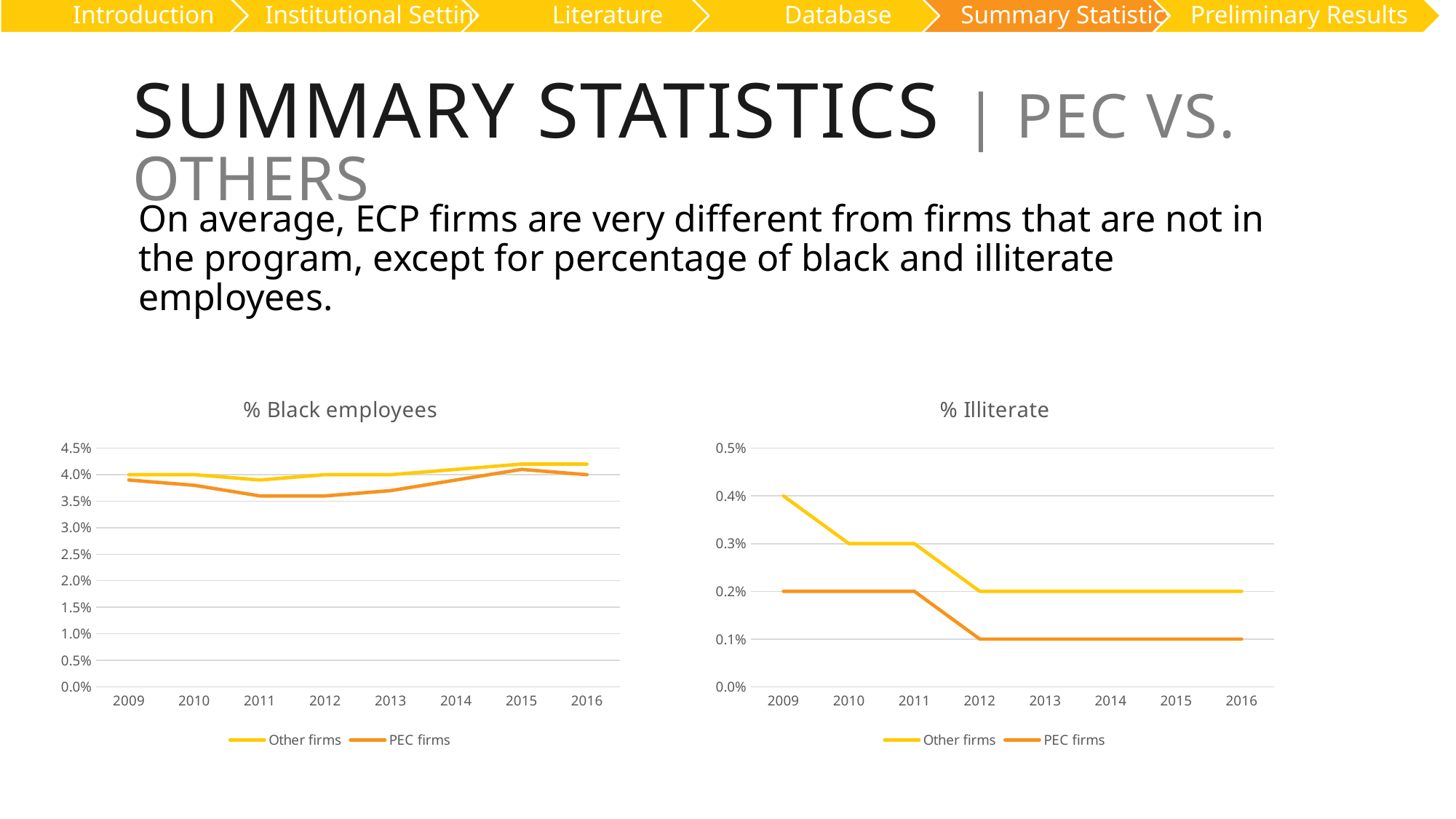
In the "% Black employees" chart, is the value for PEC firms in 2011 greater or less than 4.0%? less In the "% Black employees" chart, which series is higher in 2012, Other firms or PEC firms? Other firms How many series does the legend of the "% Illiterate" chart list? 2 In the "% Illiterate" chart, what is the value for Other firms in 2009? 0.4% What type of chart is the "% Black employees" chart? line chart What colour is the line for PEC firms in the "% Black employees" chart? orange In the "% Illiterate" chart, do the values for PEC firms rise or fall from 2009 to 2016? fall How many years are shown on the x axis of the "% Black employees" chart? 8 In the "% Illiterate" chart, what is the value for Other firms in 2011? 0.3% In the "% Illiterate" chart, what is the difference between Other firms and PEC firms in 2009? 0.2% In the "% Illiterate" chart, what is the value for PEC firms in 2016? 0.1% In the "% Illiterate" chart, which year has the highest value for Other firms? 2009